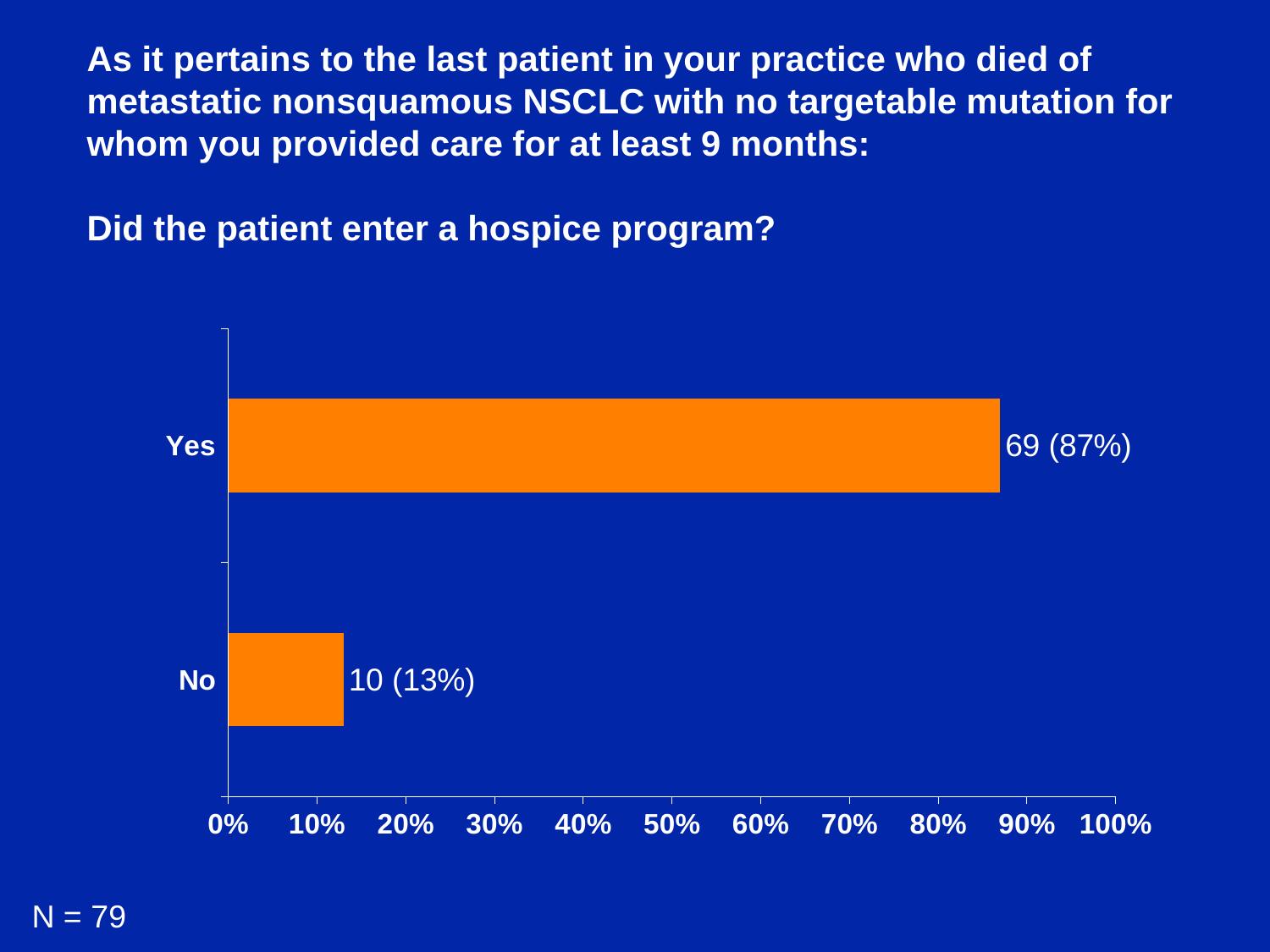
Which category has the lowest value? No What kind of chart is shown on the slide? Bar chart What is the data label shown for the "Yes" bar? 69 (87%) What is the difference in percentage points between the "Yes" and "No" bars? 74 Which category has the highest value? Yes How many categories are shown in the chart? 2 How many more respondents answered "Yes" than "No"? 59 Is the value for "Yes" greater or less than 80%? greater What percentage of respondents answered "Yes"? 87% Which is larger, the value for "Yes" or the value for "No"? Yes How many respondents answered "No"? 10 What is the data label shown for the "No" bar? 10 (13%)